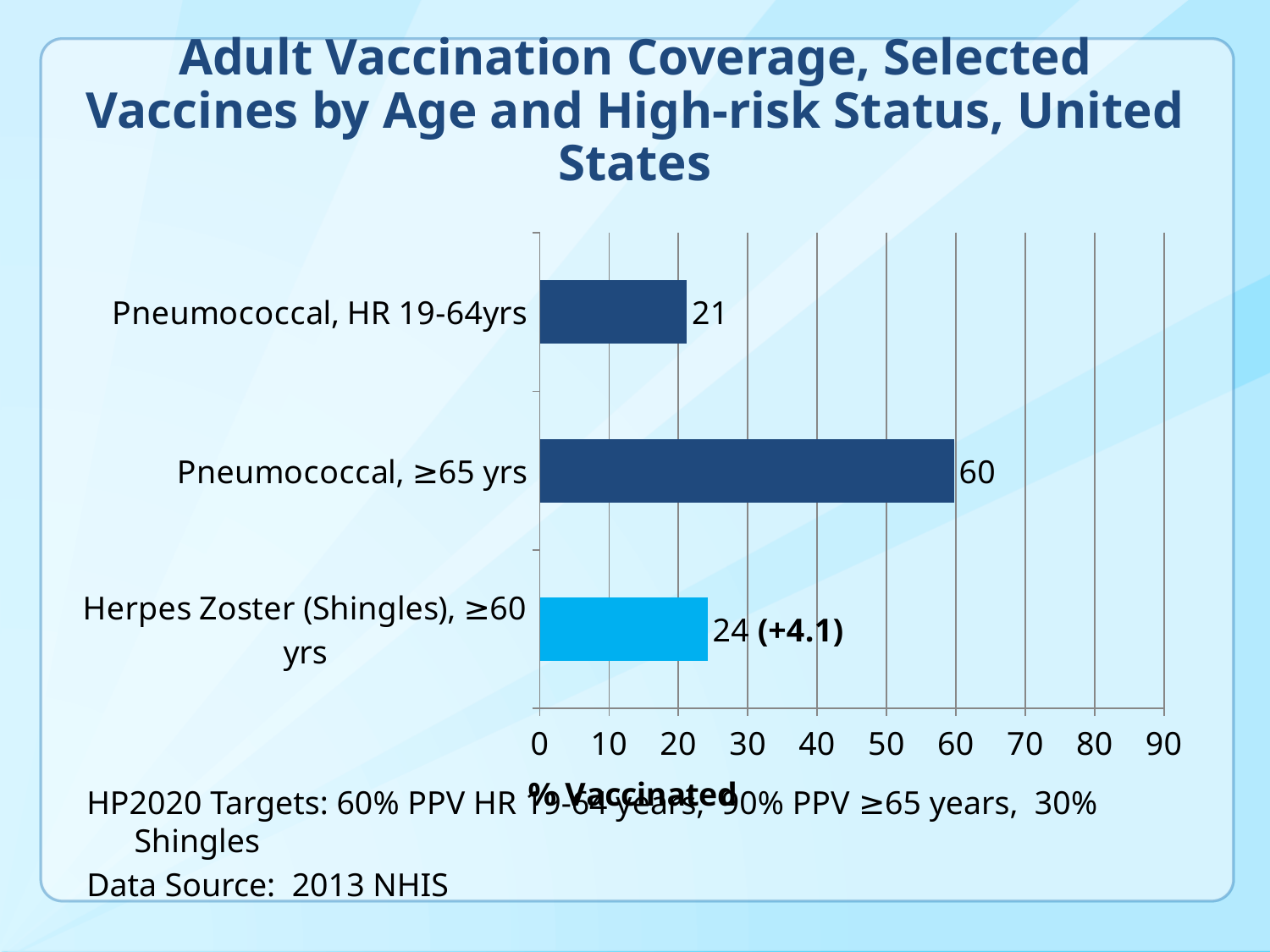
What is the value for Pneumococcal, ≥65 yrs? 60 Which category has the highest value? Pneumococcal, ≥65 yrs What is the label of the horizontal axis? % Vaccinated Which is larger, the value for Herpes Zoster (Shingles), ≥60 yrs or the value for Pneumococcal, HR 19-64yrs? Herpes Zoster (Shingles), ≥60 yrs What is the value for Herpes Zoster (Shingles), ≥60 yrs? 24 What is the value for Pneumococcal, HR 19-64yrs? 21 Which category has the lowest value? Pneumococcal, HR 19-64yrs What kind of chart is shown on the slide? bar chart Is the value for Pneumococcal, ≥65 yrs greater or less than 50? greater What is the difference between the values for Pneumococcal, ≥65 yrs and Pneumococcal, HR 19-64yrs? 39 What is the difference between the values for Herpes Zoster (Shingles), ≥60 yrs and Pneumococcal, HR 19-64yrs? 3 How many categories are shown in the chart? 3